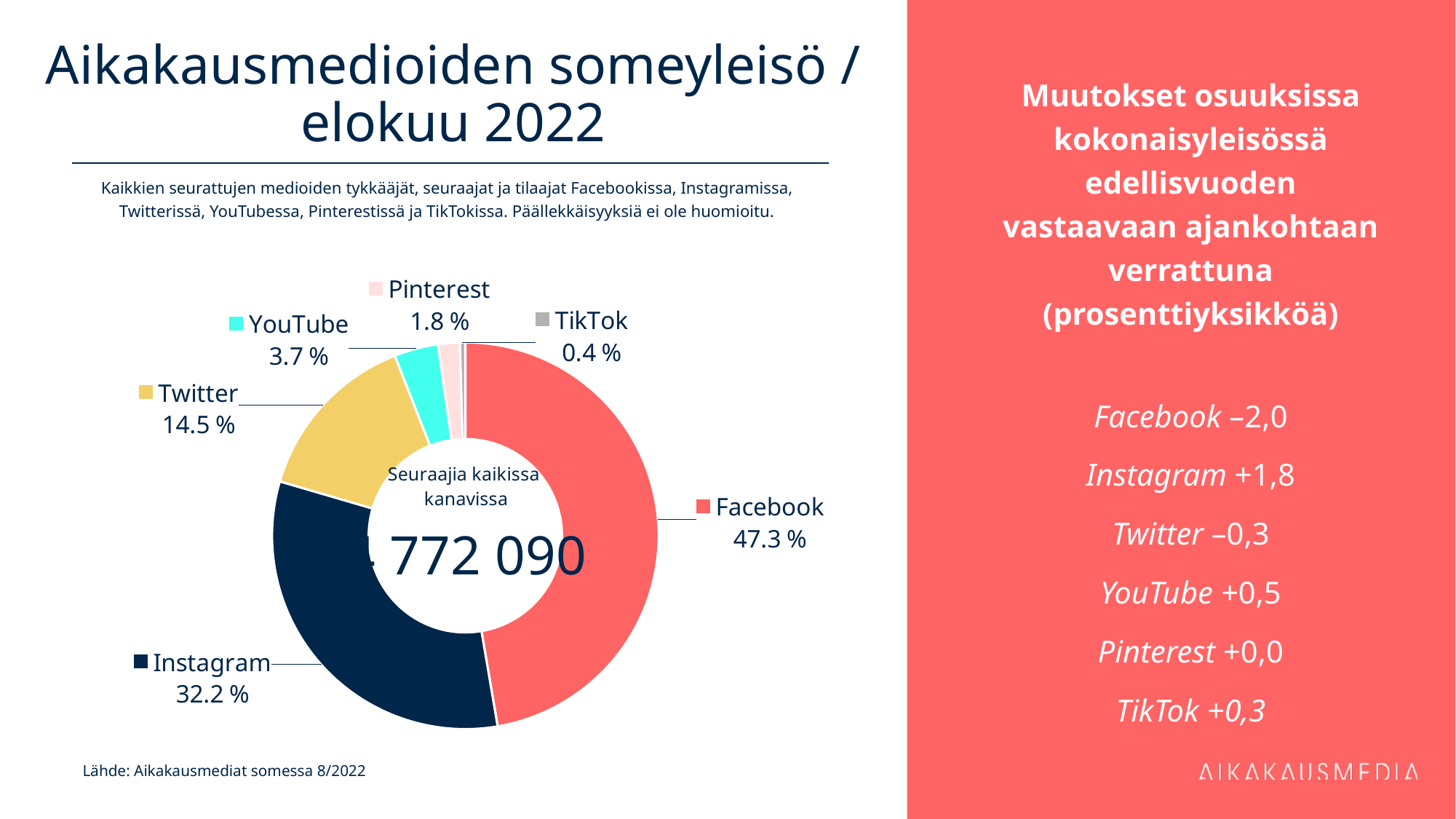
What share does TikTok hold in the chart? 0.4 % What share does Instagram hold in the chart? 32.2 % Which platform has the smallest share in the chart? TikTok Which has a larger share, Twitter or YouTube? Twitter What type of chart is shown on the slide? Doughnut chart What is the combined share of Pinterest and TikTok? 2.2 % What share of the social media audience does Facebook hold in the doughnut chart? 47.3 % What share does YouTube hold in the chart? 3.7 % What is the difference in percentage points between Facebook's and Instagram's shares? 15.1 How many platforms are shown in the chart? 6 What share does Twitter hold in the chart? 14.5 % Which platform has the largest share in the chart? Facebook